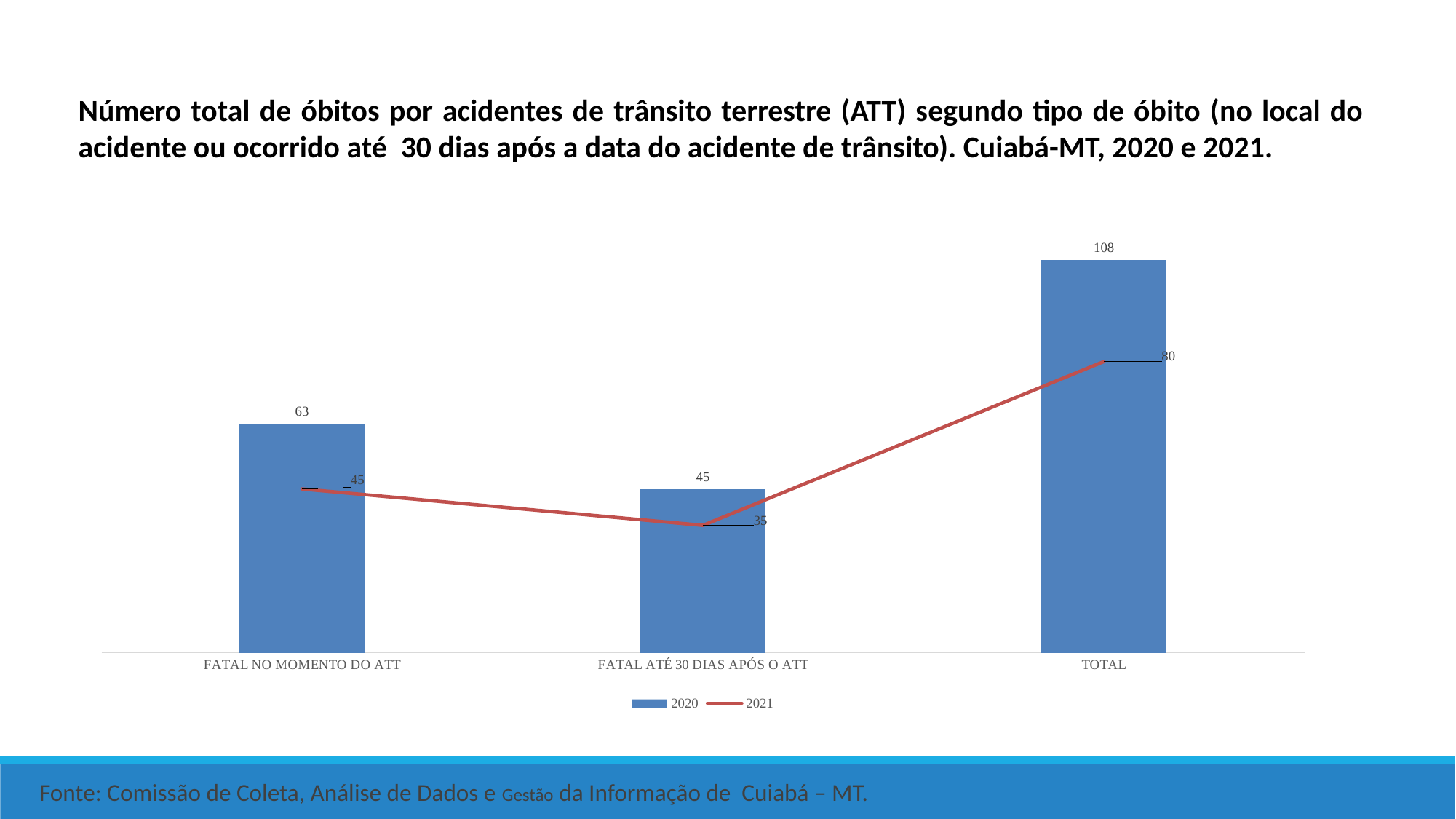
What is the 2020 value for TOTAL? 108 What is the difference between the 2020 and 2021 values for FATAL NO MOMENTO DO ATT? 18 Which is larger: the 2020 value for FATAL ATÉ 30 DIAS APÓS O ATT or the 2021 value for FATAL NO MOMENTO DO ATT? They are equal (45) Which category has the highest 2020 value? TOTAL What is the 2020 value for FATAL NO MOMENTO DO ATT? 63 How many categories are shown on the x axis? 3 How many series does the legend list? 2 What is the 2021 value for TOTAL? 80 What is the difference between the 2020 and 2021 values for TOTAL? 28 What is the 2021 value for FATAL ATÉ 30 DIAS APÓS O ATT? 35 Which category has the lowest 2021 value? FATAL ATÉ 30 DIAS APÓS O ATT How is the 2021 series drawn on the chart? As a red line